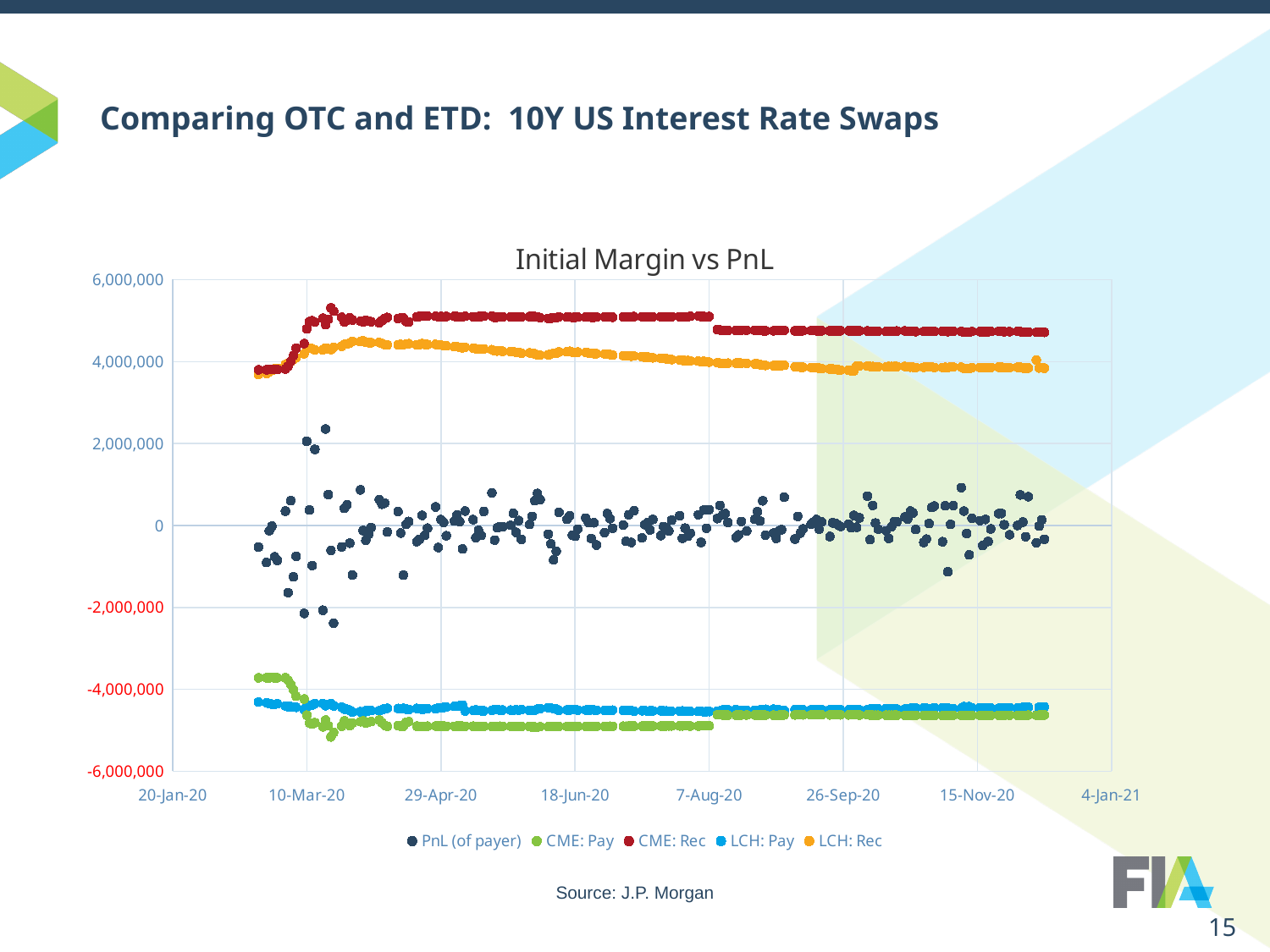
Which series in the "Initial Margin vs PnL" chart is plotted lowest on the chart? CME: Pay What kind of chart is shown on the slide? Scatter chart Do the LCH: Rec values rise or fall between April 2020 and November 2020? fall Which series has higher values, CME: Rec or LCH: Rec? CME: Rec How many series does the legend of the "Initial Margin vs PnL" chart list? 5 Which series in the "Initial Margin vs PnL" chart is plotted highest on the chart? CME: Rec Are the values for CME: Pay in November 2020 greater or less than -4,000,000? less What is the source cited for the chart? J.P. Morgan What is the title of the chart on the slide? Initial Margin vs PnL Are the values for LCH: Pay greater or less than -4,000,000 throughout the chart? less Which series has lower values, CME: Pay or LCH: Pay? CME: Pay